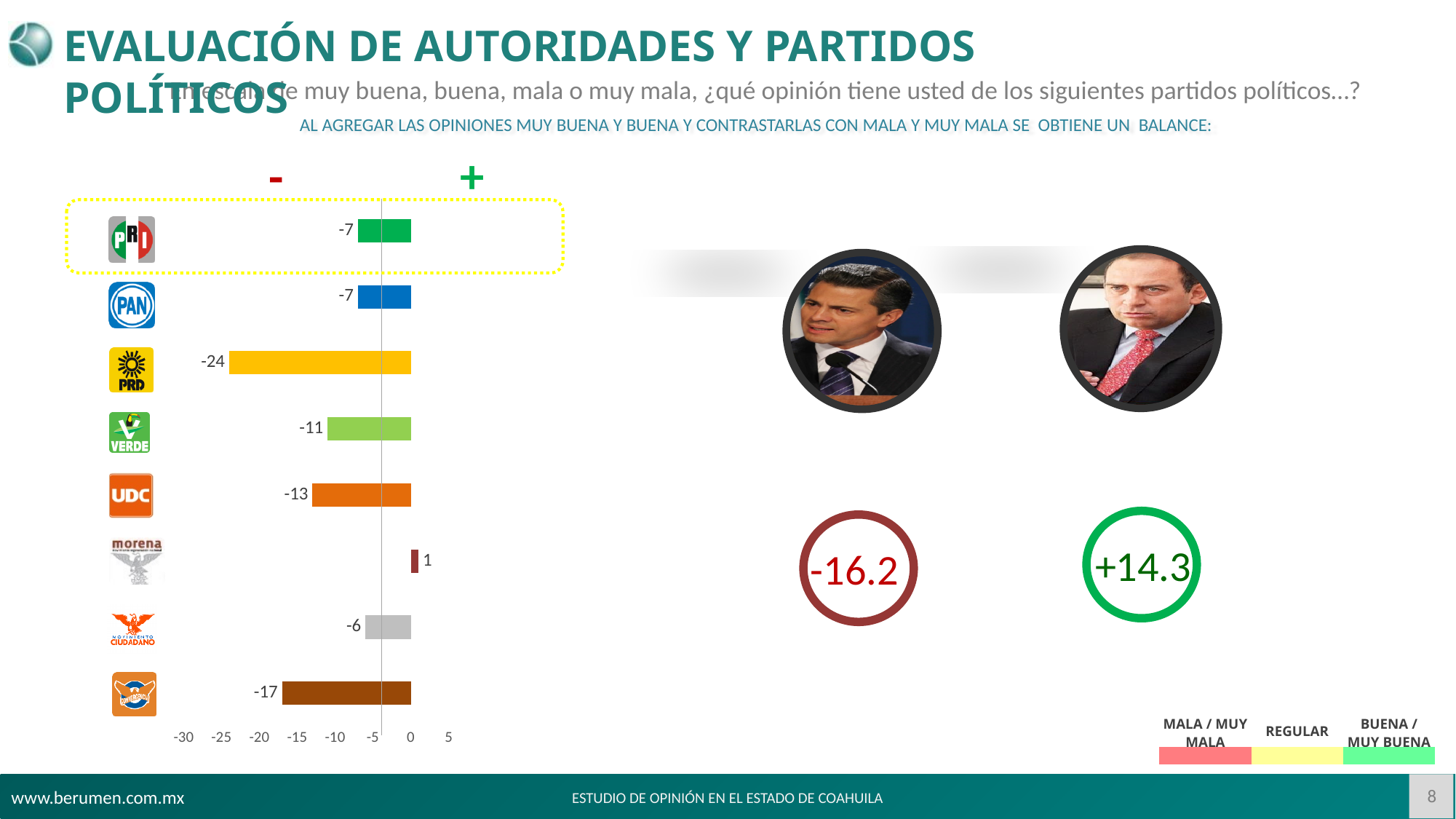
What is the balance value shown for Movimiento Ciudadano? -6 What is the balance value shown for morena? 1 Which party has the highest balance in the chart? morena What is the difference between the balance values of PRD and VERDE? 13 Which party has the lowest (most negative) balance in the chart? PRD What is the balance value shown for VERDE? -11 Which has a higher balance value, UDC or PAN? PAN What is the balance value shown for UDC? -13 What type of chart is used to show the party balances? Bar chart How many parties are shown in the bar chart? 8 What is the balance value shown for PAN? -7 What is the balance value shown for PRD? -24